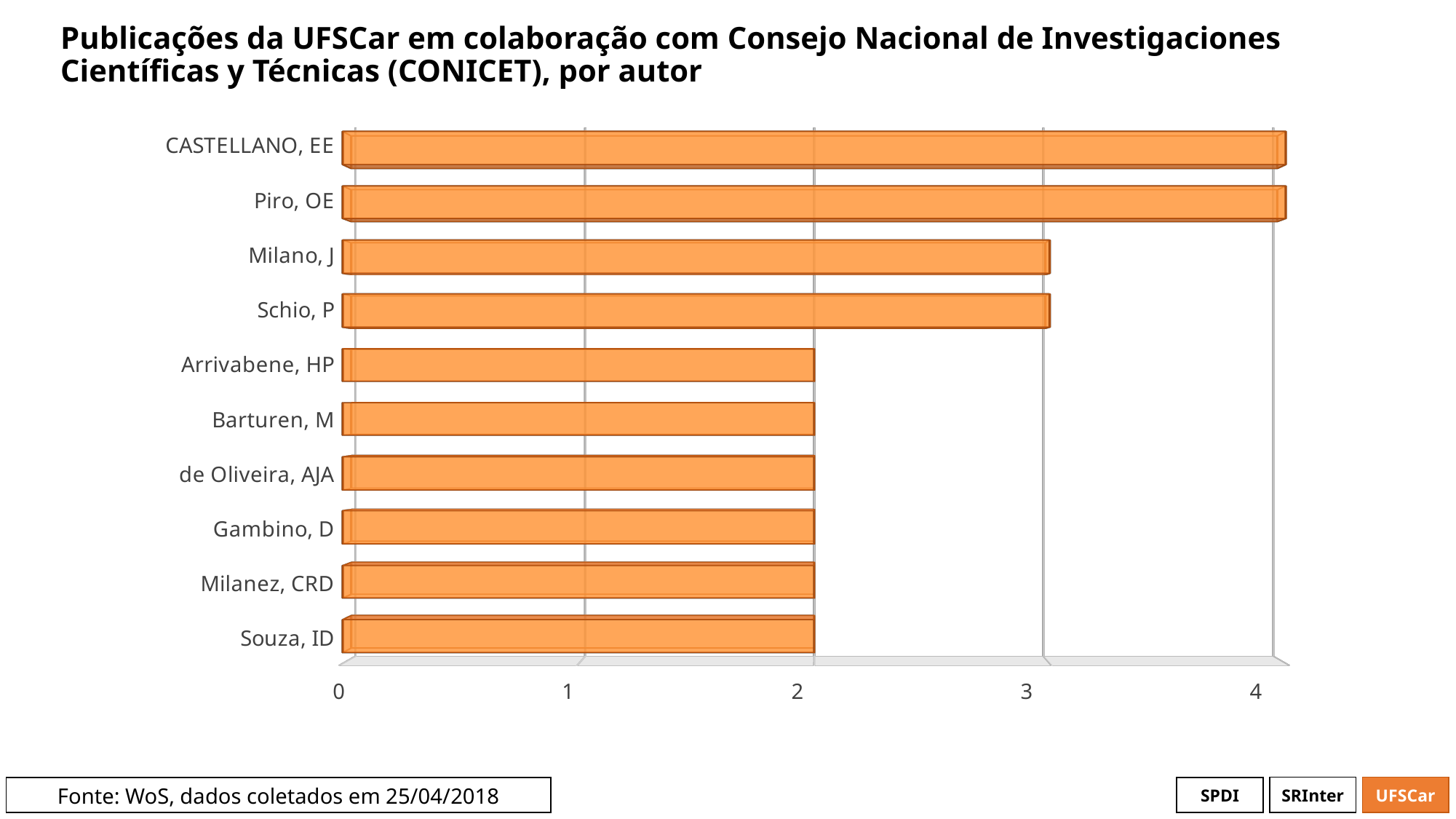
How many publications does the bar for CASTELLANO, EE reach on the axis? 4 Is the value for Barturen, M greater or less than 3? less Which is larger, the value for Milano, J or the value for Gambino, D? Milano, J Is the value for Schio, P greater or less than 2? greater Do the bar values increase or decrease going from the top author to the bottom author? decrease What colour are the bars on the chart? orange What kind of chart is shown on the slide? bar chart How many publications does the bar for Souza, ID reach on the axis? 2 What is the difference between the values for CASTELLANO, EE and Souza, ID? 2 How many authors are listed on the chart? 10 How many publications does the bar for Milano, J reach on the axis? 3 Which is larger, the value for Piro, OE or the value for Schio, P? Piro, OE